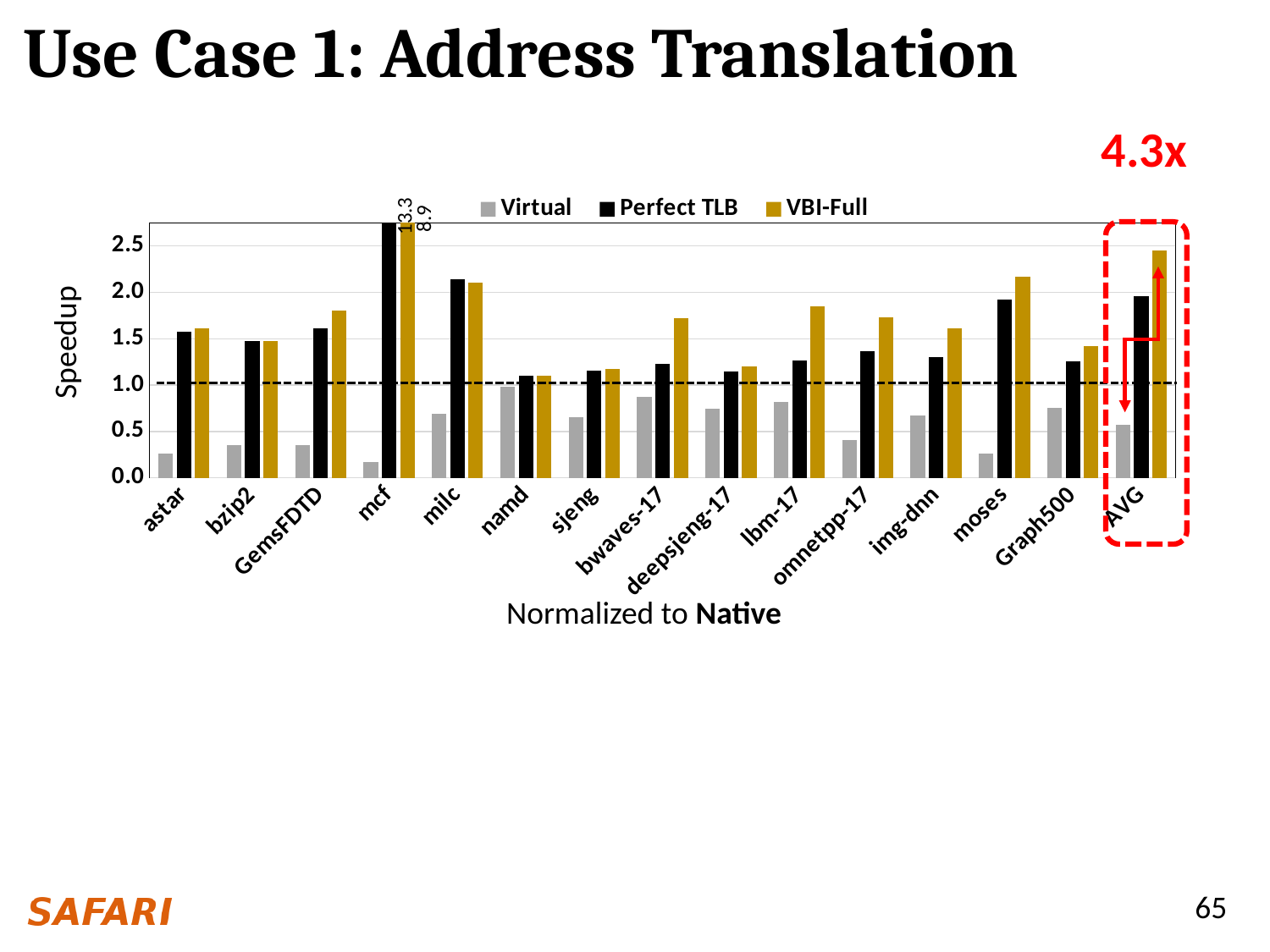
Which category has the lowest Virtual speedup? mcf What kind of chart is shown on the slide? bar chart Which category has the highest Perfect TLB speedup? mcf What is the Perfect TLB speedup for mcf? 8.9 What is the VBI-Full speedup for mcf? 13.3 What is the difference between the Perfect TLB and VBI-Full speedups for mcf? 4.4 How many categories are shown along the x axis? 15 Is the Virtual value for astar greater or less than 0.5? less For mcf, which is larger: the Perfect TLB speedup or the VBI-Full speedup? VBI-Full Is the VBI-Full value for AVG greater or less than 2.0? greater What is the label on the y axis of the chart? Speedup How many series does the legend list? 3